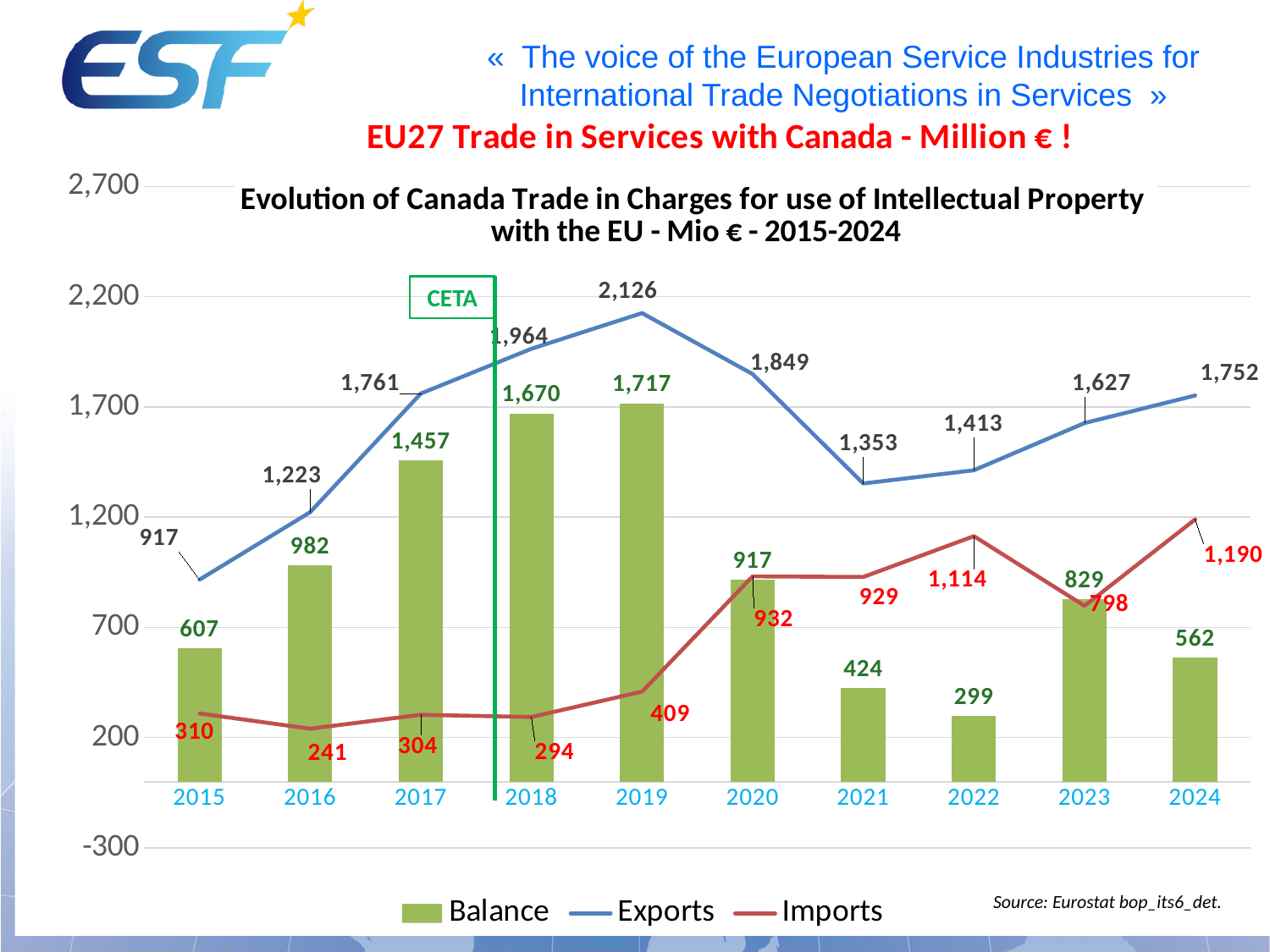
Is the value of Exports in 2021 greater or less than 1,200? greater How many years are shown on the x axis? 10 What was the value of Exports in 2019? 2,126 Which was larger in 2023, the Balance or Imports? Balance Did Imports rise or fall from 2019 to 2020? rise How many series does the legend list? 3 What is the difference between Exports and Imports in 2020? 917 What was the value of Imports in 2024? 1,190 In which year were Imports lowest? 2016 In which year was the Balance highest? 2019 What label appears in the green box marking the vertical line between 2017 and 2018? CETA What was the Balance in 2022? 299